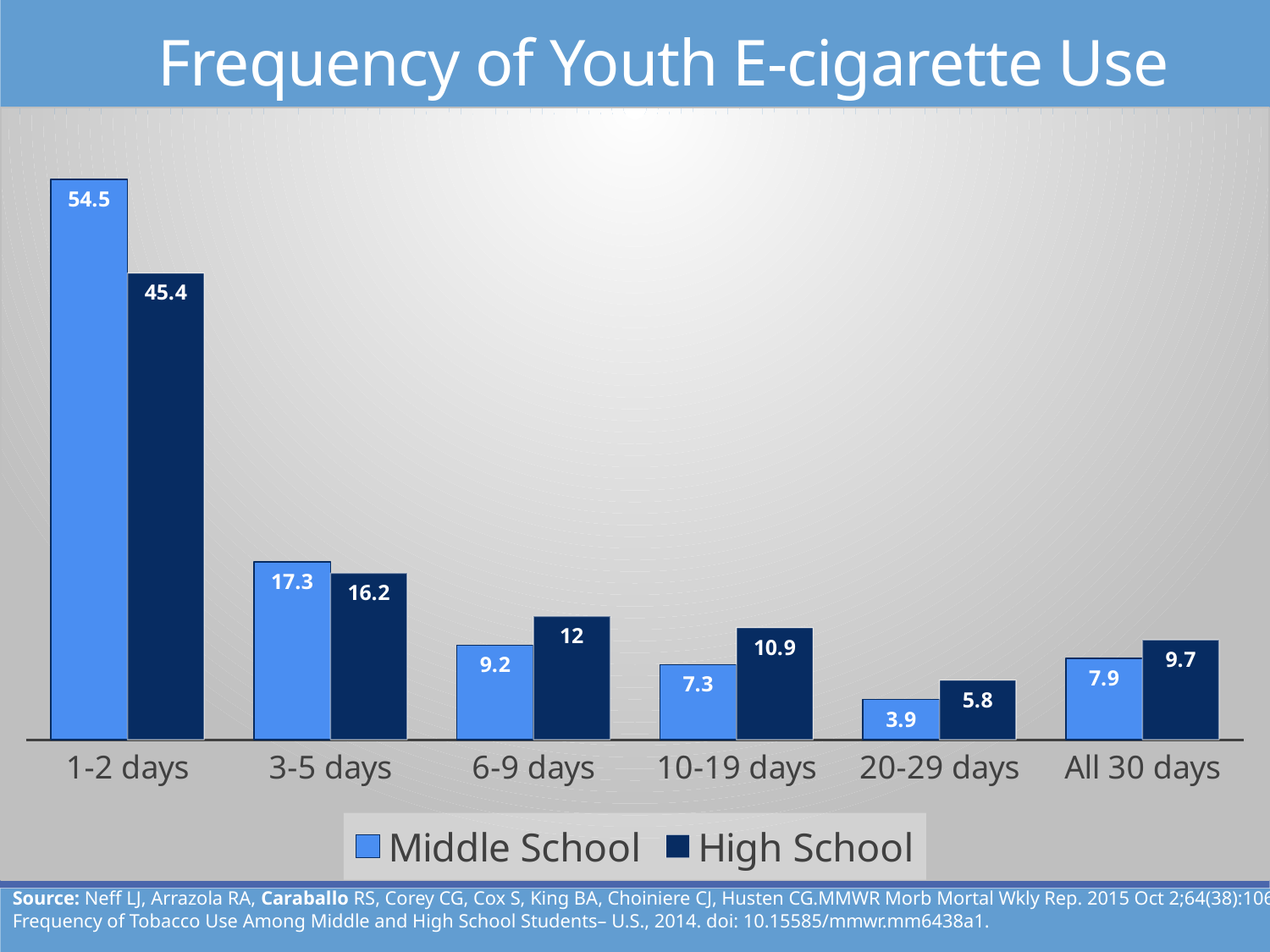
What is the High School value for 6-9 days? 12 What is the difference between the High School values for 3-5 days and 10-19 days? 5.3 What is the High School value for All 30 days? 9.7 For 3-5 days, which is larger: Middle School or High School? Middle School What is the difference between the Middle School and High School values for 1-2 days? 9.1 What kind of chart is shown on the slide? Bar chart How many frequency categories are shown on the x axis? 6 Which category has the highest Middle School value? 1-2 days What is the Middle School value for 1-2 days? 54.5 For 10-19 days, which is larger: Middle School or High School? High School How many series does the legend list? 2 Which category has the lowest High School value? 20-29 days